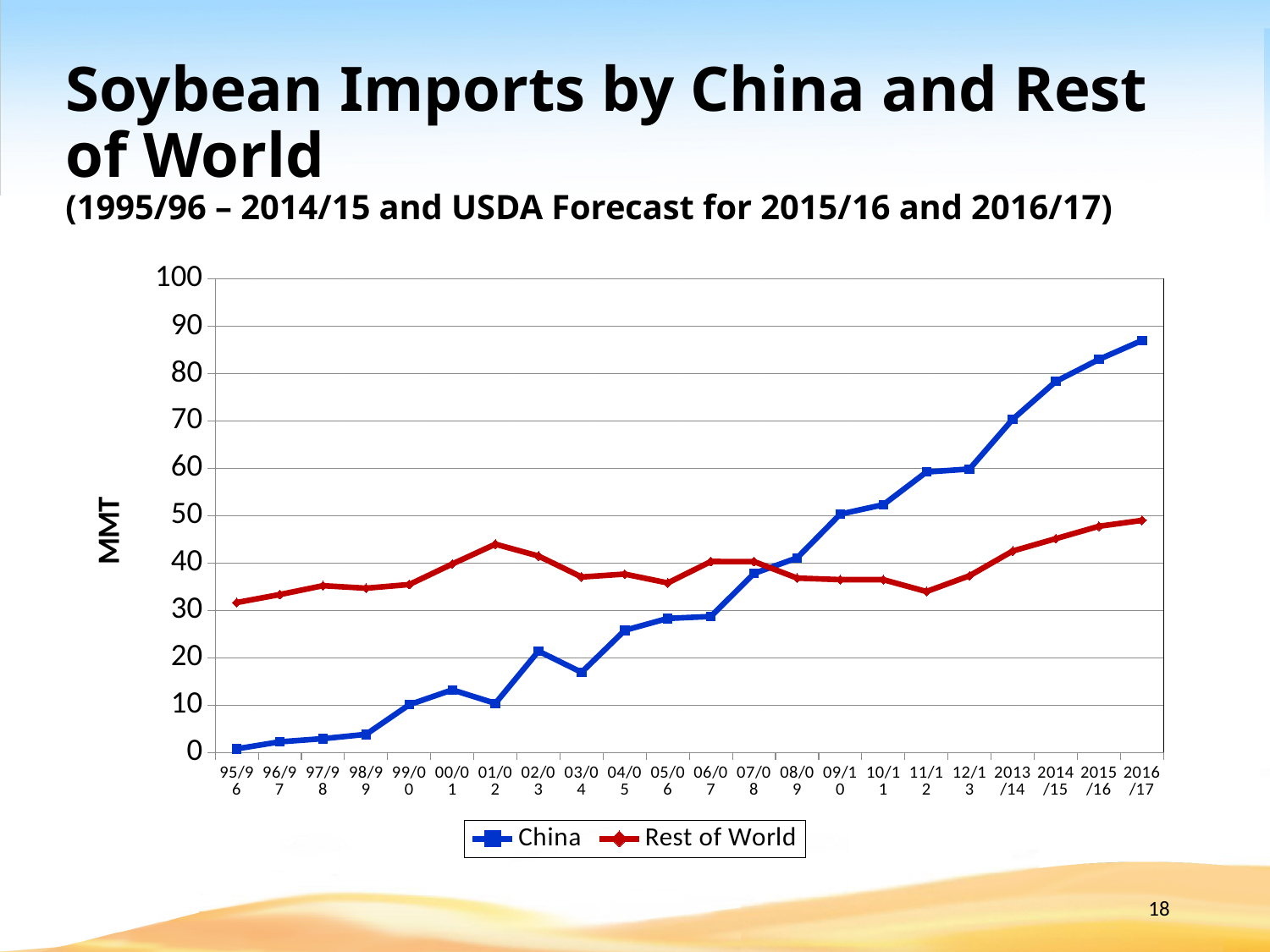
Does the China series generally rise or fall from 95/96 to 2016/17? rise In 2016/17, which series has the larger value, China or Rest of World? China Is the value for Rest of World in 01/02 greater or less than 40? greater What kind of chart is shown on the slide? line chart Which year has the highest value for China? 2016/17 In 95/96, which series has the larger value, China or Rest of World? Rest of World Is the value for China in 95/96 greater or less than 10? less Is the value for China in 2016/17 greater or less than 80? greater How many series does the legend list? 2 Which year has the lowest value for China? 95/96 How many data points are plotted along the x axis for each series? 22